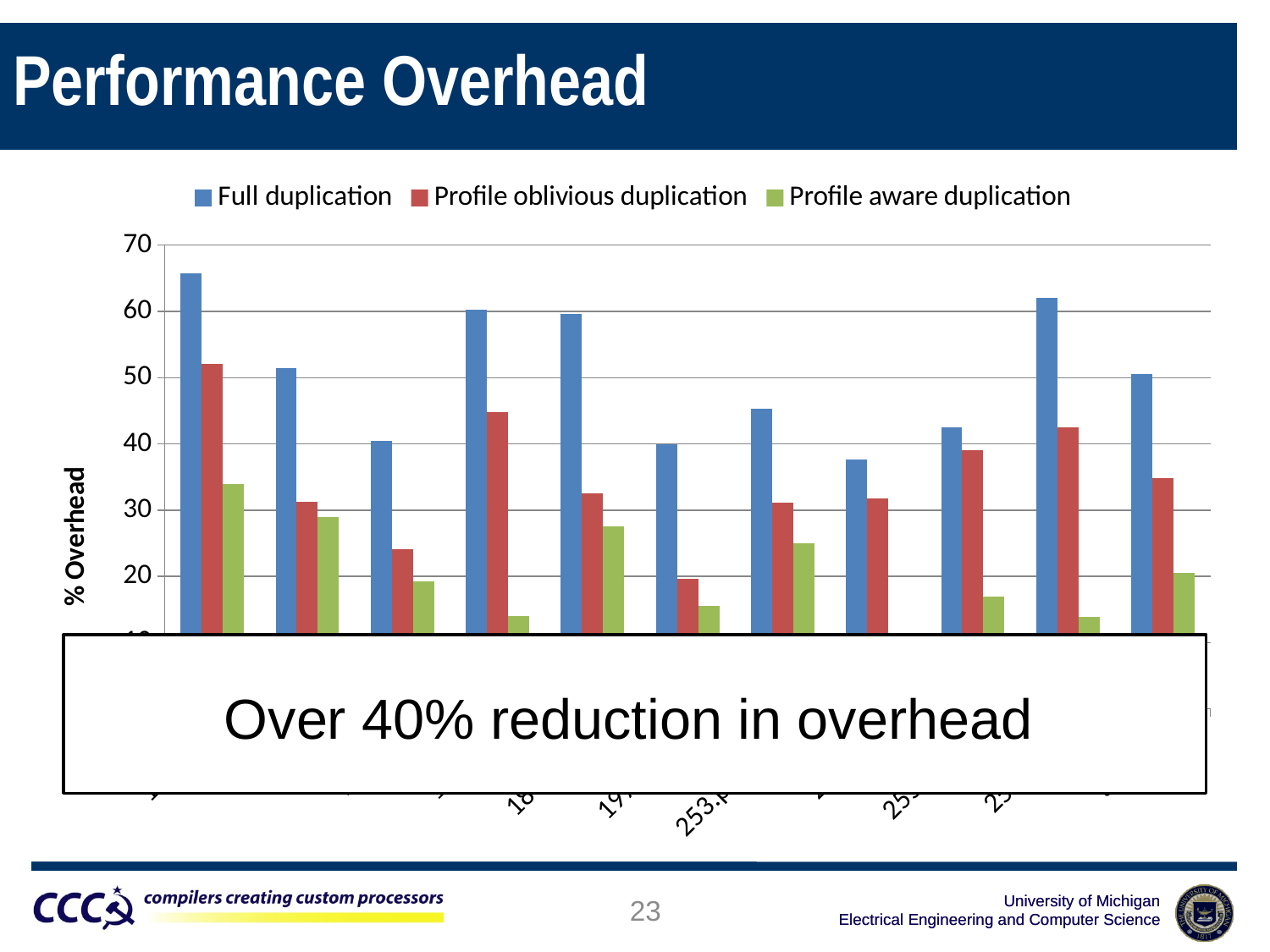
How many groups of bars are plotted along the x axis? 11 Which series has the tallest bar in every group? Full duplication Is the Full duplication value for the leftmost group greater or less than 60? greater How many series does the legend list? 3 In the leftmost group, which is larger: the Full duplication bar or the Profile aware duplication bar? Full duplication Which series has the shortest bar in the leftmost group? Profile aware duplication What is the label on the vertical axis? % Overhead What kind of chart is shown on the slide? bar chart Is the Full duplication value for the rightmost group greater or less than 40? greater Is the Profile oblivious duplication value for the leftmost group greater or less than 50? greater What are the three series named in the legend? Full duplication, Profile oblivious duplication, Profile aware duplication